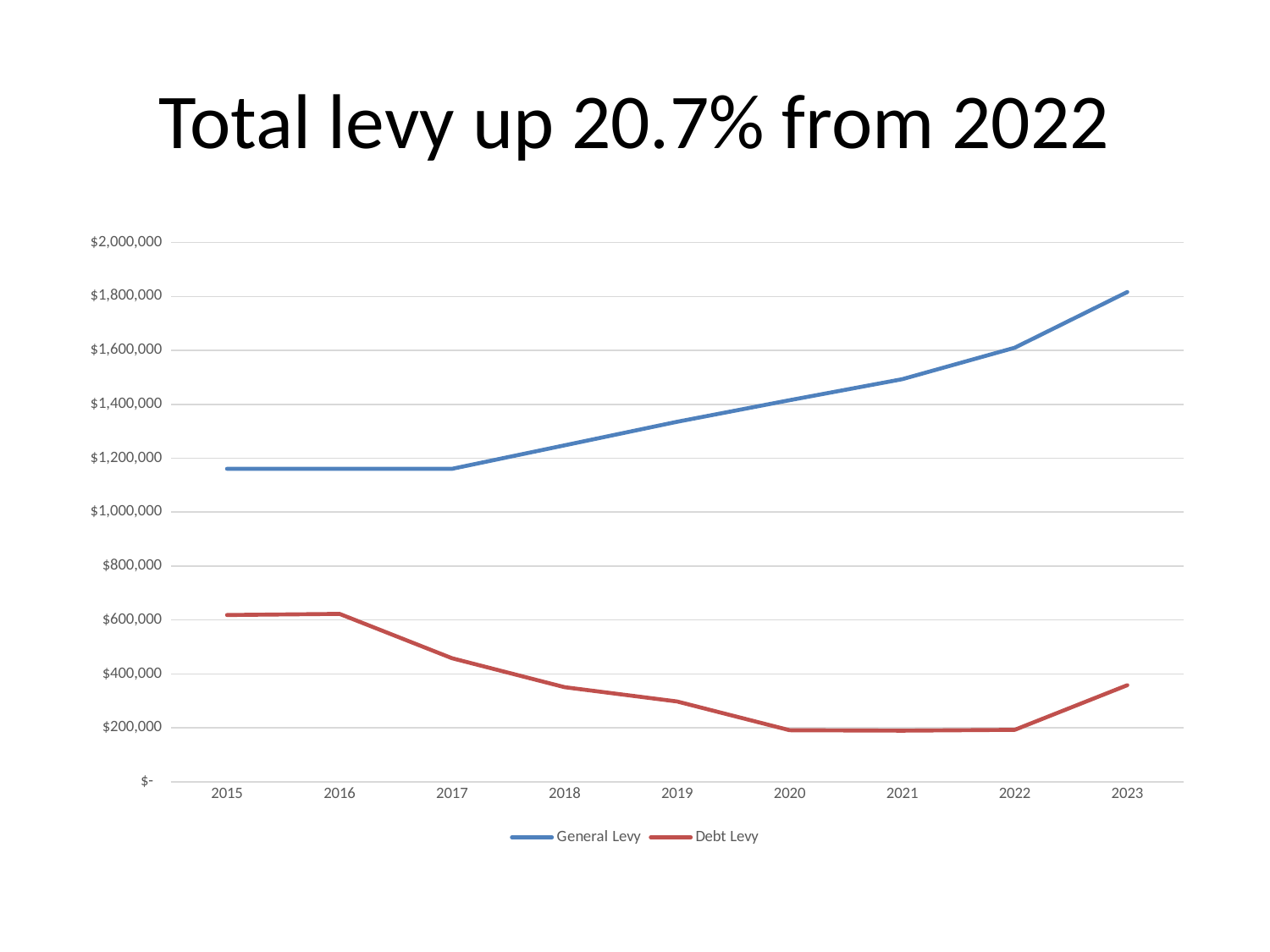
Is the Debt Levy value for 2020 greater or less than $400,000? less What kind of chart is shown on the slide? line chart Does the General Levy rise or fall from 2017 to 2023? rise How many years are plotted along the x axis? 9 What colour is the Debt Levy line? red Which is larger for the Debt Levy, the value in 2016 or the value in 2018? 2016 Which series has the larger value in 2019, General Levy or Debt Levy? General Levy Is the General Levy value for 2023 greater or less than $1,600,000? greater In which year is the General Levy highest? 2023 How many series does the legend list? 2 Is the General Levy value for 2015 greater or less than $1,000,000? greater